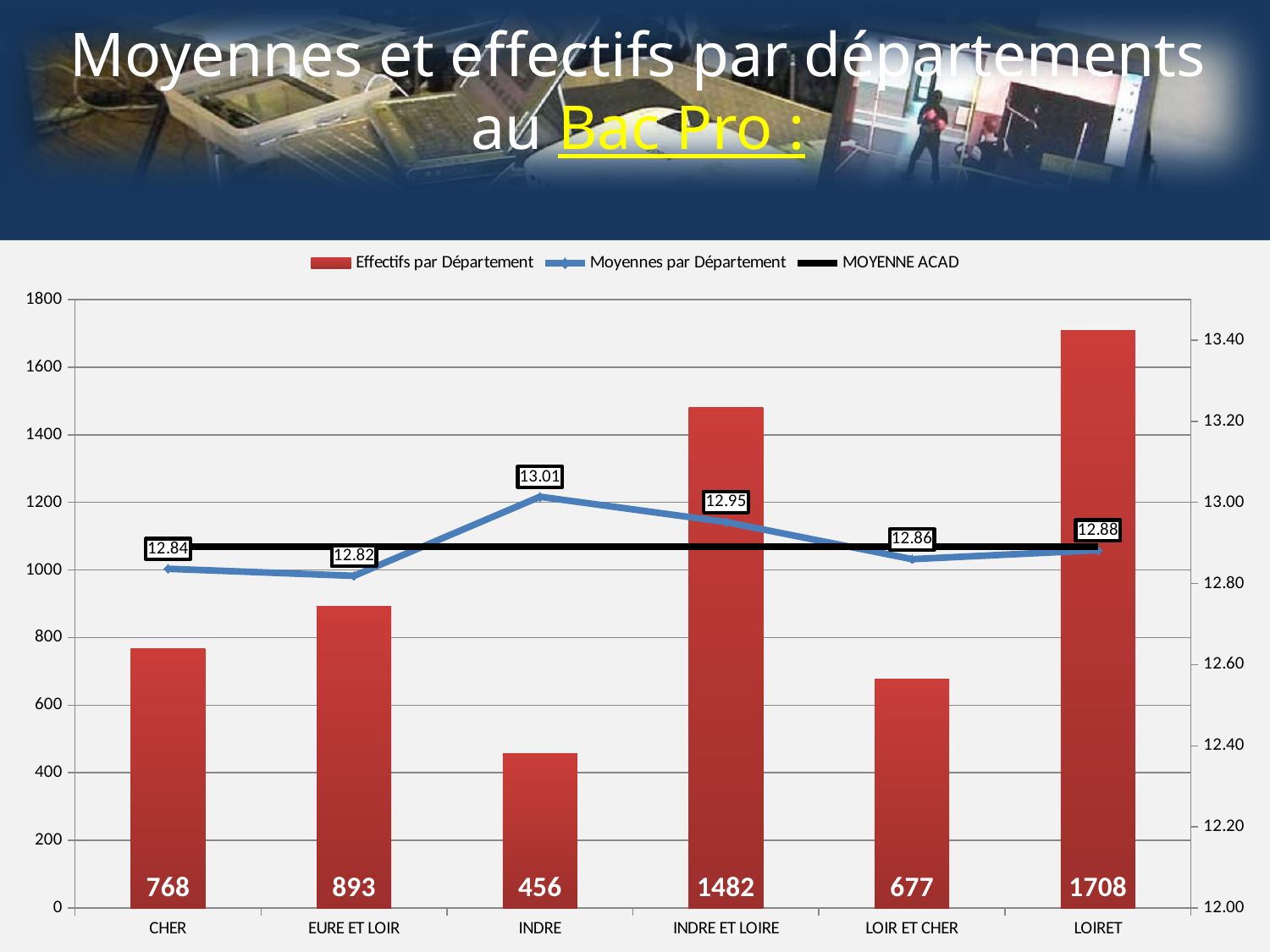
What is the value of Effectifs par Département for INDRE ET LOIRE? 1482 Which department has the lowest Effectifs par Département? INDRE Which department has the highest Effectifs par Département? LOIRET What kind of chart is used for the Effectifs par Département series? bar chart How many departments are shown on the x axis? 6 Which department has the lowest Moyennes par Département value? EURE ET LOIR Is the Effectifs par Département value for EURE ET LOIR greater or less than 1000? less Which has a higher Moyennes par Département value, INDRE ET LOIRE or LOIR ET CHER? INDRE ET LOIRE What is the Moyennes par Département value for INDRE? 13.01 What colour is the MOYENNE ACAD line? black What is the difference in Effectifs par Département between LOIRET and CHER? 940 How many series does the legend list? 3